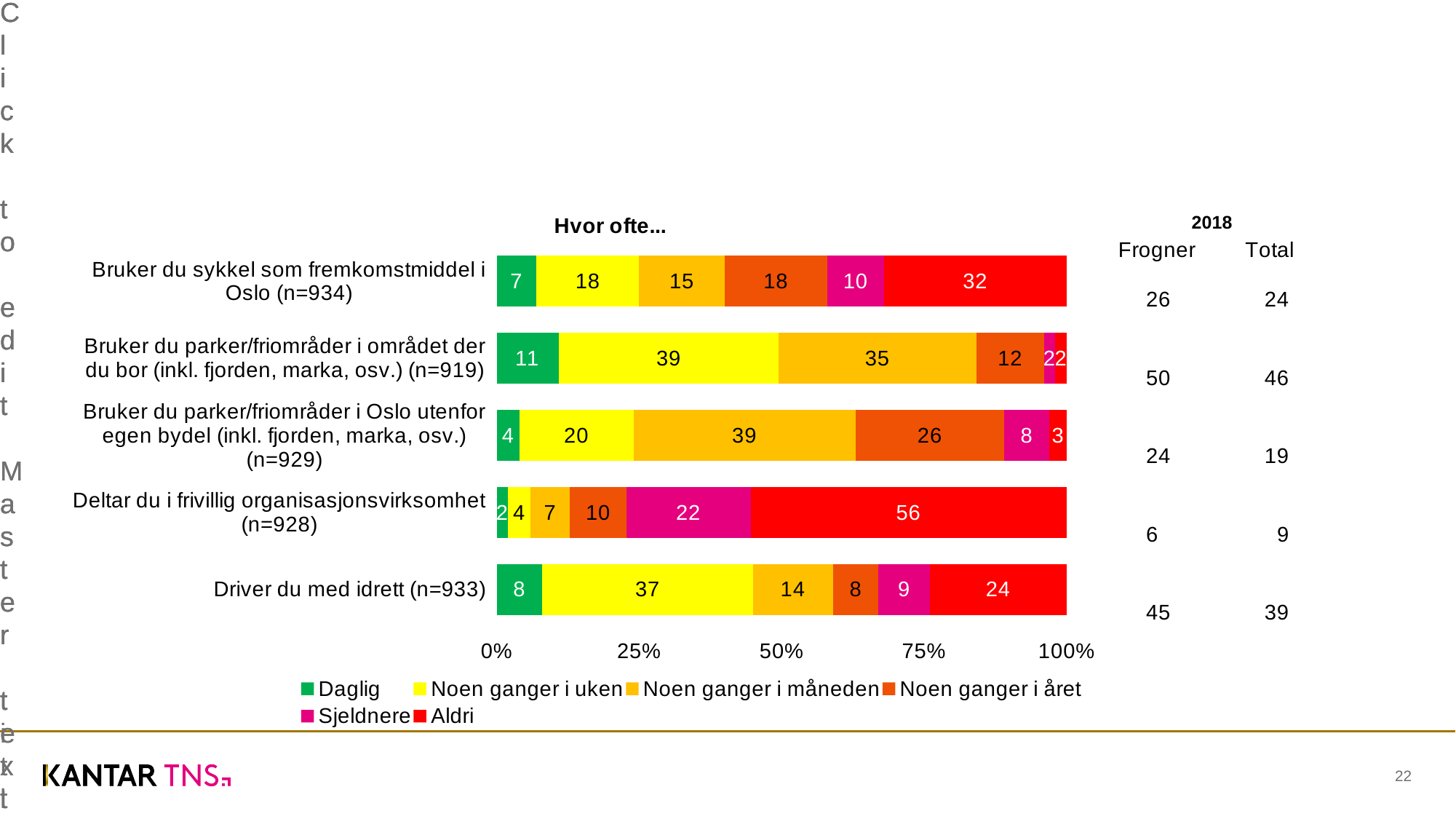
What kind of chart is shown on the slide? Stacked bar chart What is the 'Aldri' value for 'Deltar du i frivillig organisasjonsvirksomhet (n=928)'? 56 Which category has the lowest 'Aldri' value? Bruker du parker/friområder i området der du bor (inkl. fjorden, marka, osv.) (n=919) What is the title of the chart? Hvor ofte... What is the 'Daglig' value for 'Bruker du parker/friområder i området der du bor (inkl. fjorden, marka, osv.) (n=919)'? 11 What is the 'Noen ganger i uken' value for 'Driver du med idrett (n=933)'? 37 What is the 'Noen ganger i året' value for 'Bruker du parker/friområder i Oslo utenfor egen bydel (inkl. fjorden, marka, osv.) (n=929)'? 26 Which category has the highest 'Daglig' value? Bruker du parker/friområder i området der du bor (inkl. fjorden, marka, osv.) (n=919) Which is larger: the 'Sjeldnere' value for 'Deltar du i frivillig organisasjonsvirksomhet (n=928)' or for 'Bruker du sykkel som fremkomstmiddel i Oslo (n=934)'? Deltar du i frivillig organisasjonsvirksomhet (n=928) What is the difference between the 'Aldri' values for 'Bruker du sykkel som fremkomstmiddel i Oslo (n=934)' and 'Driver du med idrett (n=933)'? 8 How many series does the legend list? 6 How many categories (questions) are plotted in the chart? 5